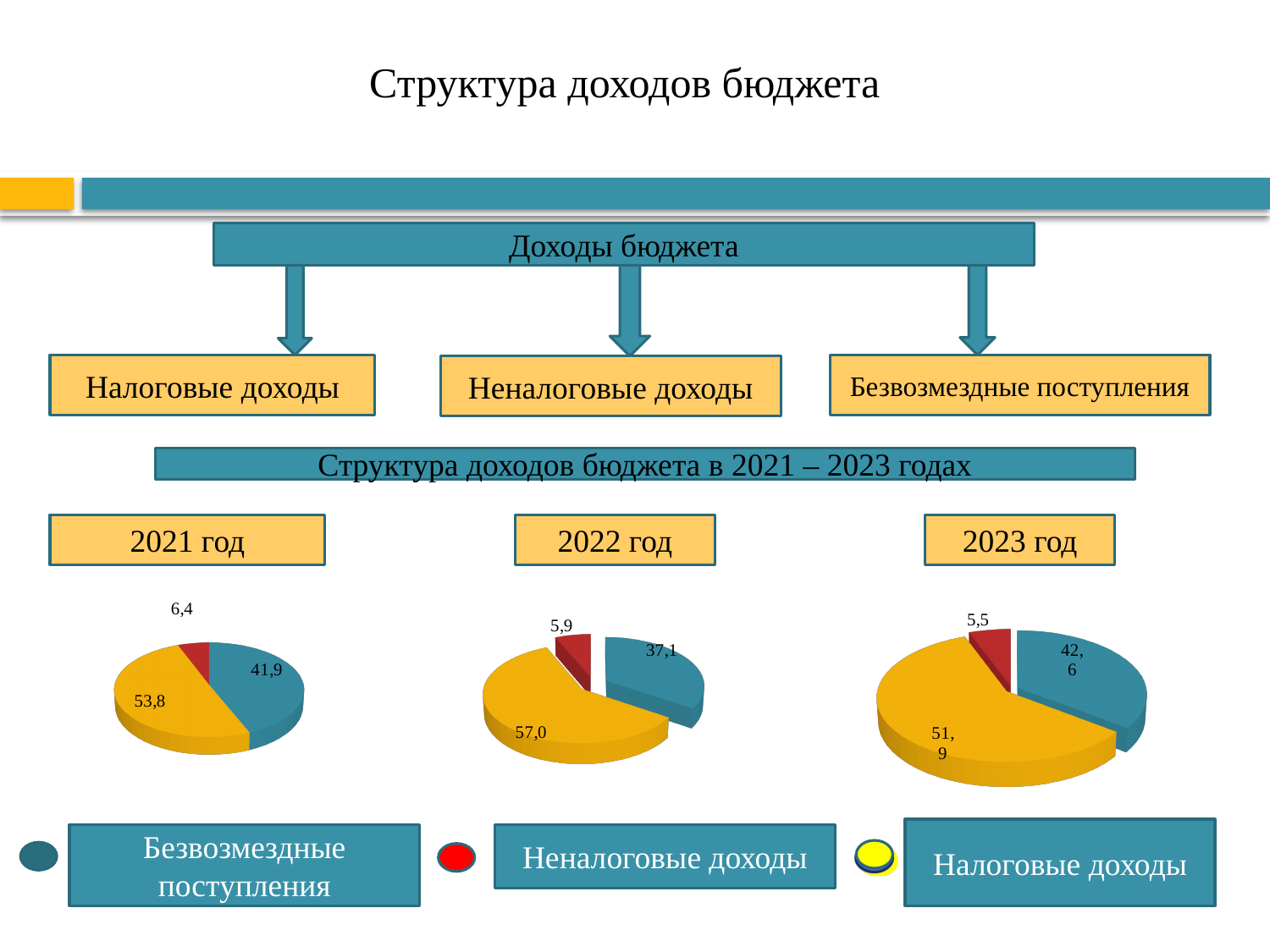
In the 2022 год pie chart, what is the value for Неналоговые доходы? 5,9 In the 2022 год pie chart, what is the value for Безвозмездные поступления? 37,1 In the 2023 год pie chart, what is the value for Неналоговые доходы? 5,5 In the 2023 год pie chart, what is the value for Безвозмездные поступления? 42,6 In the 2021 год pie chart, which is larger: Налоговые доходы or Безвозмездные поступления? Налоговые доходы In the 2021 год pie chart, which category has the smallest slice? Неналоговые доходы What type of chart is used for the 2023 год data? Pie chart Which colour represents Налоговые доходы in the pie charts? Yellow How many slices does the 2022 год pie chart have? 3 In the 2022 год pie chart, which category has the largest slice? Налоговые доходы In the 2021 год pie chart, what is the value for Налоговые доходы? 53,8 In the 2023 год pie chart, what is the difference between the values for Налоговые доходы and Безвозмездные поступления? 9,3